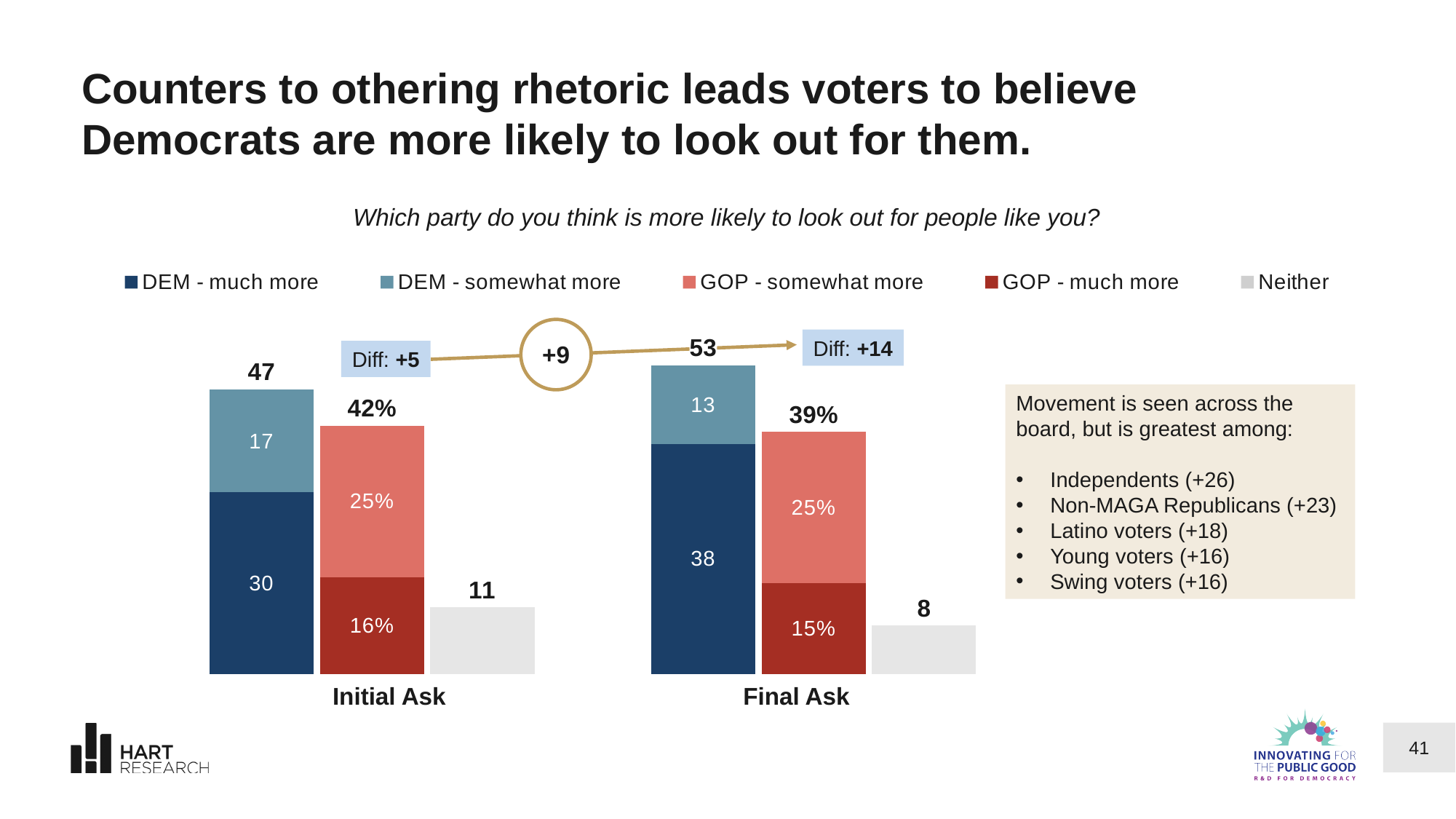
What kind of chart is shown on the slide? Stacked bar chart What is the difference between the DEM - much more values for the Final Ask and the Initial Ask? 8 What is the value for Neither in the Final Ask? 8 What is the total of the stacked DEM bar in the Final Ask? 53 How many categories are shown on the x axis? 2 What is the value for DEM - much more in the Initial Ask? 30 Does the Neither value rise or fall from the Initial Ask to the Final Ask? Fall What is the total of the stacked GOP bar in the Initial Ask? 42% What is the value for DEM - somewhat more in the Final Ask? 13 Which is larger in the Final Ask: the DEM stacked total or the GOP stacked total? DEM stacked total What is the value for GOP - much more in the Initial Ask? 16% How many series does the legend list? 5